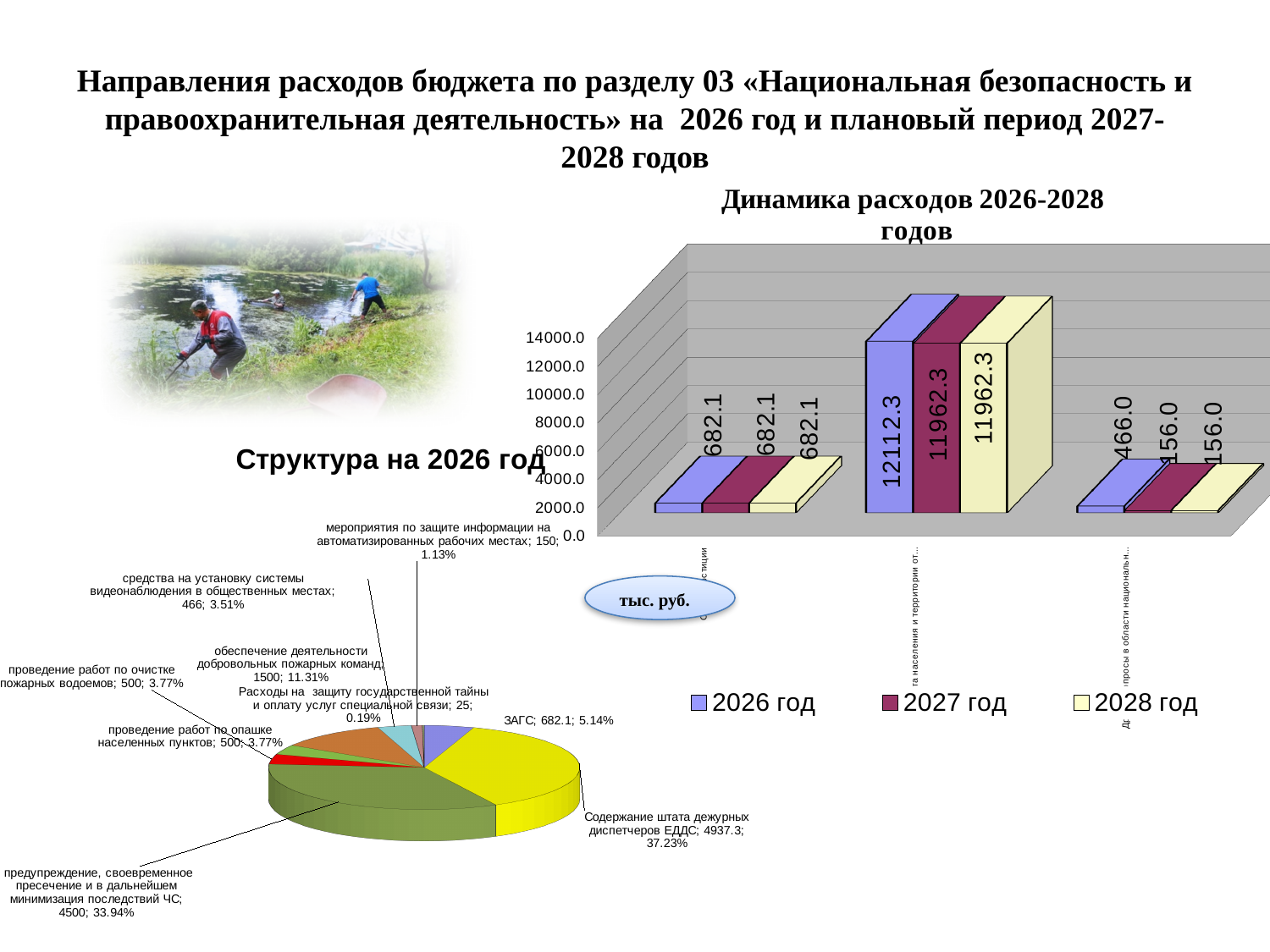
On the chart titled «Динамика расходов 2026-2028 годов», what is the value for 2026 год in the rightmost group of bars? 466.0 On the chart titled «Динамика расходов 2026-2028 годов», what is the difference between the 2026 год and 2027 год values in the middle (second) group of bars? 150.0 On the chart titled «Структура на 2026 год», which slice is the smallest? Расходы на защиту государственной тайны и оплату услуг специальной связи On the chart titled «Динамика расходов 2026-2028 годов», how many series does the legend list? 3 On the chart titled «Структура на 2026 год», what is the value for «обеспечение деятельности добровольных пожарных команд»? 1500 On the chart titled «Динамика расходов 2026-2028 годов», what kind of chart is shown? Bar chart On the chart titled «Динамика расходов 2026-2028 годов», what is the value for 2026 год in the middle (second) group of bars? 12112.3 On the chart titled «Структура на 2026 год», what is the value for «Содержание штата дежурных диспетчеров ЕДДС»? 4937.3 On the chart titled «Структура на 2026 год», what share of the pie does «предупреждение, своевременное пресечение и в дальнейшем минимизация последствий ЧС» represent? 33.94% On the chart titled «Структура на 2026 год», how many slices does the pie have? 9 On the chart titled «Динамика расходов 2026-2028 годов», what is the value for 2027 год in the middle (second) group of bars? 11962.3 On the chart titled «Динамика расходов 2026-2028 годов», which is larger in the rightmost group: the 2026 год value or the 2028 год value? 2026 год